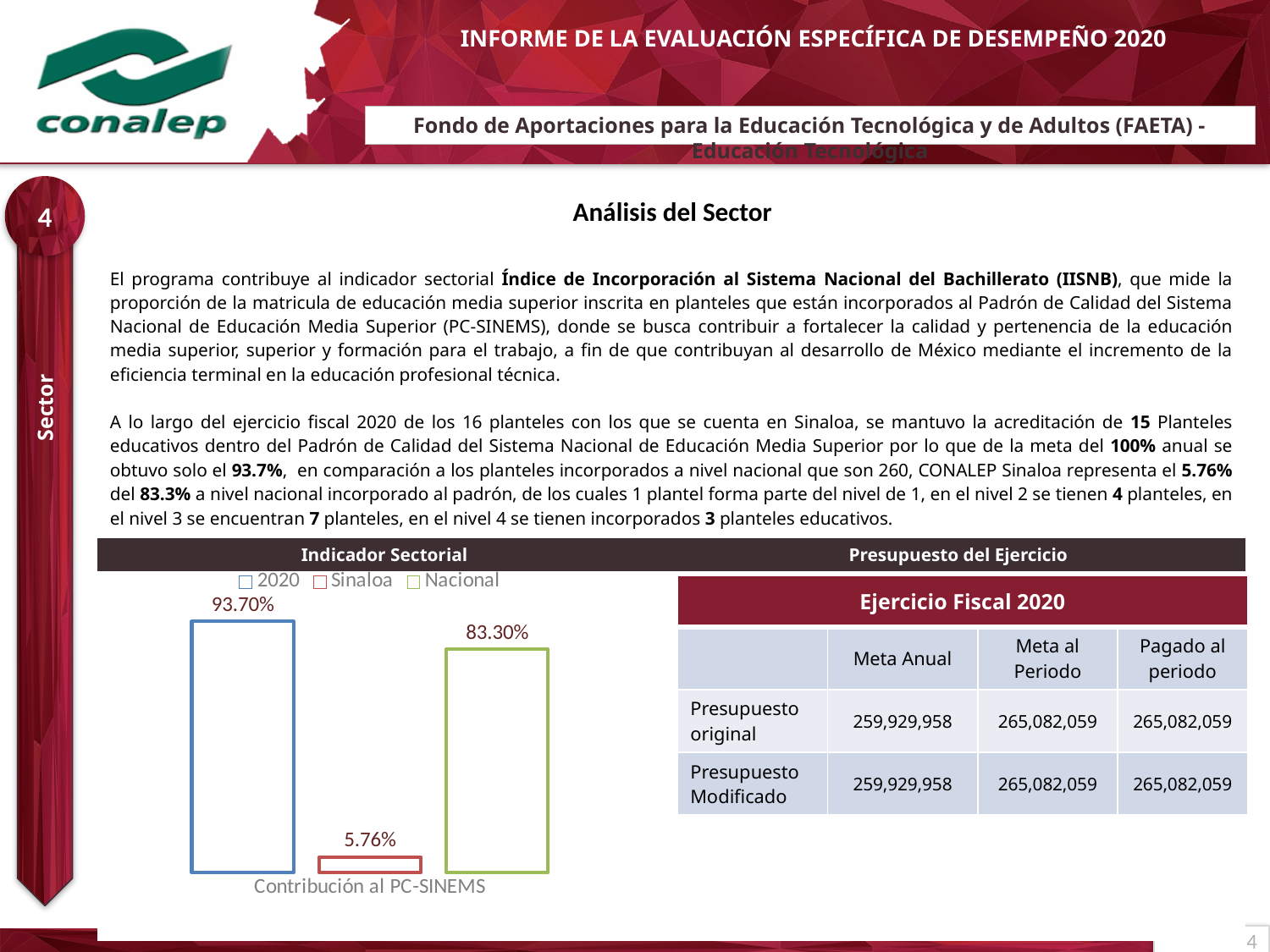
What is the value of the Sinaloa series in the Indicador Sectorial chart? 5.76% What is the category label on the x axis of the Indicador Sectorial chart? Contribución al PC-SINEMS What is the value of the 2020 series in the Indicador Sectorial chart? 93.70% Which series has the highest value in the Indicador Sectorial chart? 2020 What is the value of the Nacional series in the Indicador Sectorial chart? 83.30% What type of chart is shown under "Indicador Sectorial"? bar chart What is the difference between the 2020 value and the Nacional value in the Indicador Sectorial chart? 10.40% How many series does the legend of the Indicador Sectorial chart list? 3 Which series has the lowest value in the Indicador Sectorial chart? Sinaloa What colour is the outline of the Sinaloa bar in the Indicador Sectorial chart? red In the Indicador Sectorial chart, which is larger: the 2020 value or the Nacional value? 2020 What is the difference between the Nacional value and the Sinaloa value in the Indicador Sectorial chart? 77.54%